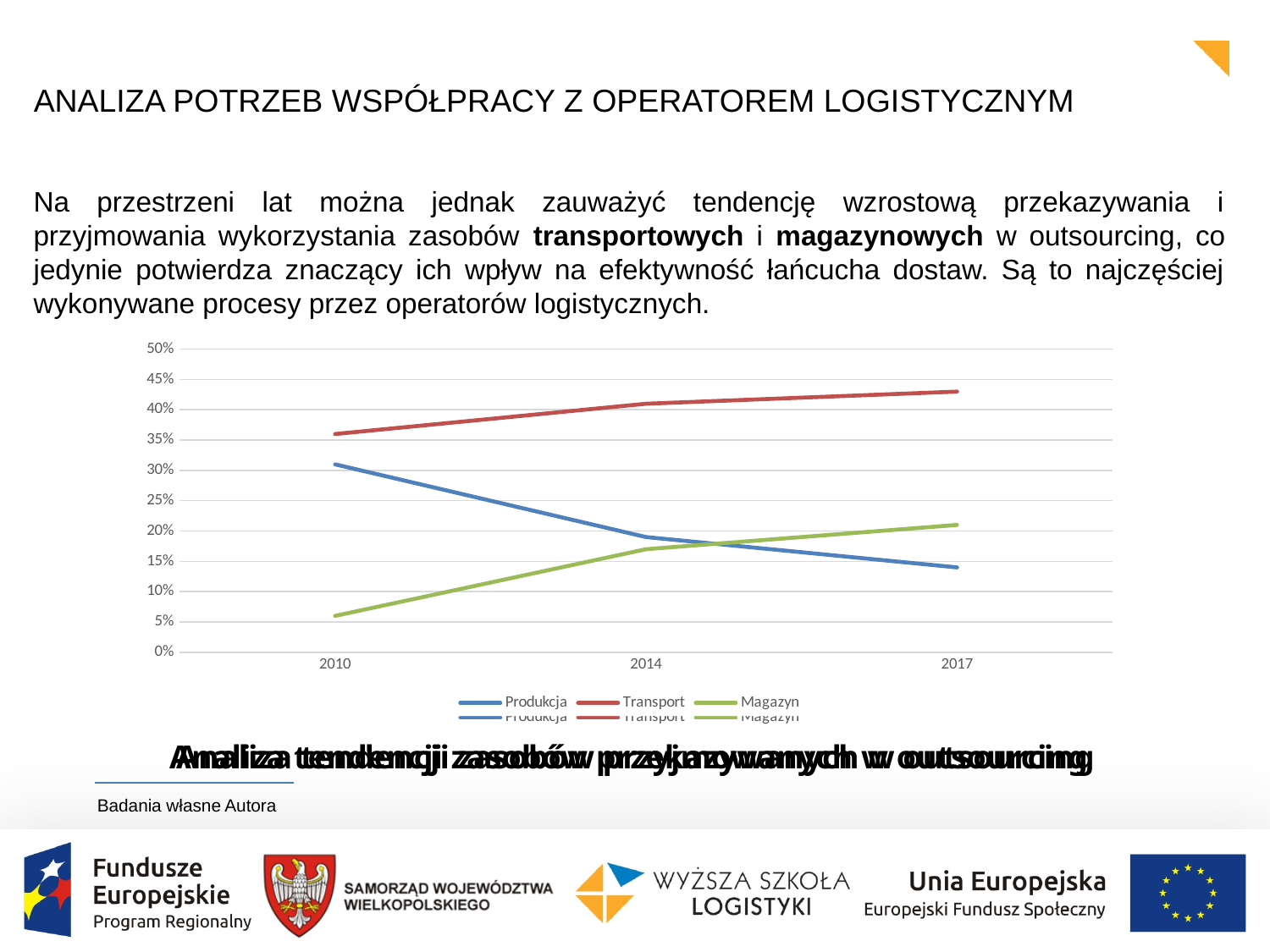
Does the Transport line rise or fall from 2010 to 2017? rise In 2017, which is larger: Produkcja or Magazyn? Magazyn Is the value for Magazyn in 2010 greater or less than 10%? less Is the value for Transport in 2010 greater or less than 30%? greater What kind of chart is shown on the slide? line chart Does the Produkcja line rise or fall from 2010 to 2017? fall How many years are shown on the x axis? 3 Which series has the highest value in 2017? Transport What colour is the Transport line? red How many series does the legend list? 3 Which series has the lowest value in 2010? Magazyn Does the Magazyn line rise or fall from 2010 to 2017? rise